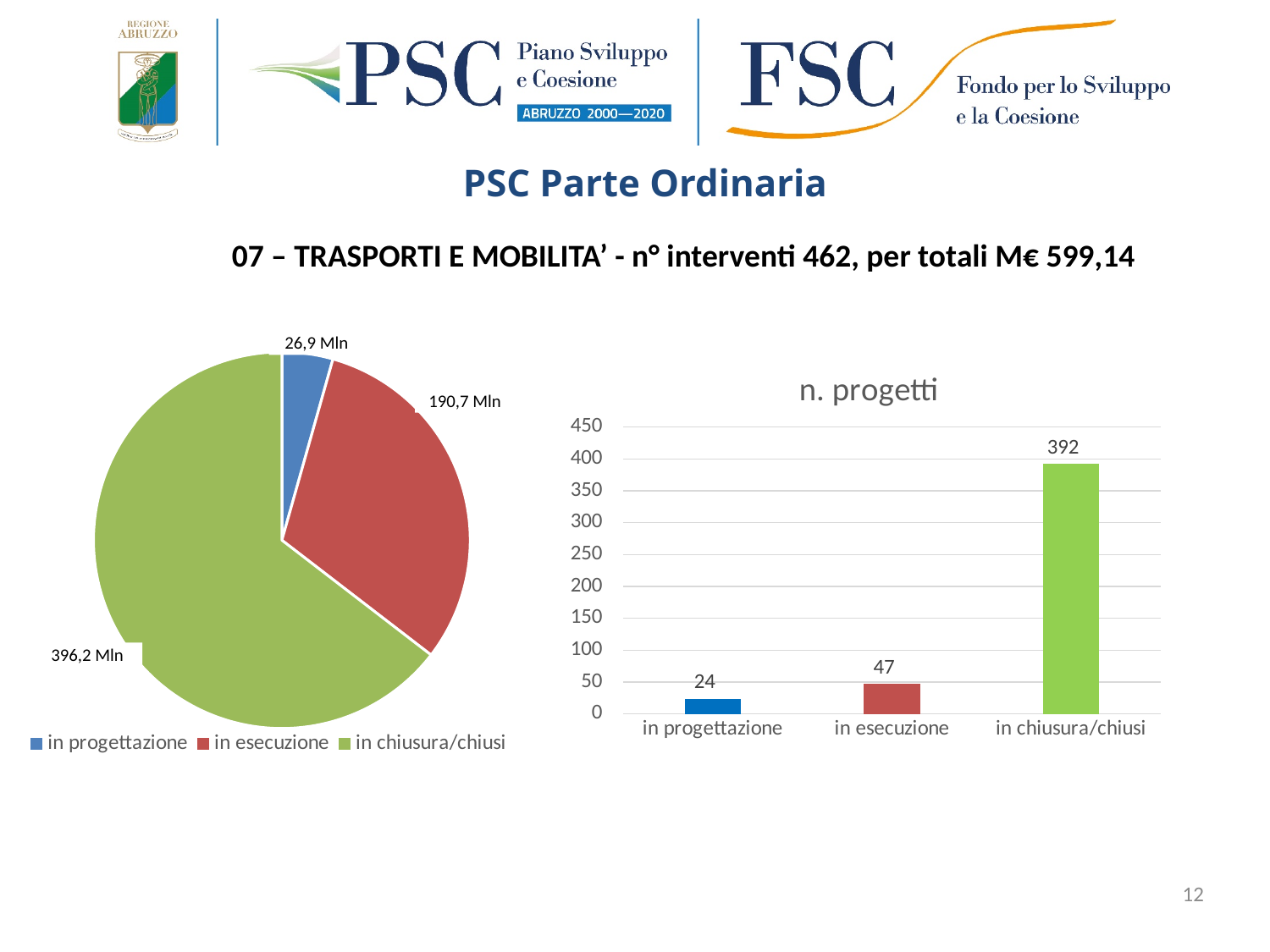
In the bar chart titled "n. progetti", do the values rise or fall from left to right along the x axis? rise In the pie chart on the left, what is the value for "in esecuzione"? 190,7 Mln In the pie chart on the left, which category has the largest slice? in chiusura/chiusi In the bar chart titled "n. progetti", what is the difference between "in chiusura/chiusi" and "in esecuzione"? 345 In the pie chart on the left, which is larger: "in progettazione" or "in esecuzione"? in esecuzione In the bar chart titled "n. progetti", what is the value for "in progettazione"? 24 In the bar chart titled "n. progetti", what is the value for "in chiusura/chiusi"? 392 In the pie chart on the left, what is the difference between "in chiusura/chiusi" and "in esecuzione"? 205,5 Mln What kind of chart is the chart titled "n. progetti"? bar chart In the pie chart on the left, how many entries does the legend list? 3 In the bar chart titled "n. progetti", how many categories are shown on the x axis? 3 In the bar chart titled "n. progetti", which category has the lowest value? in progettazione